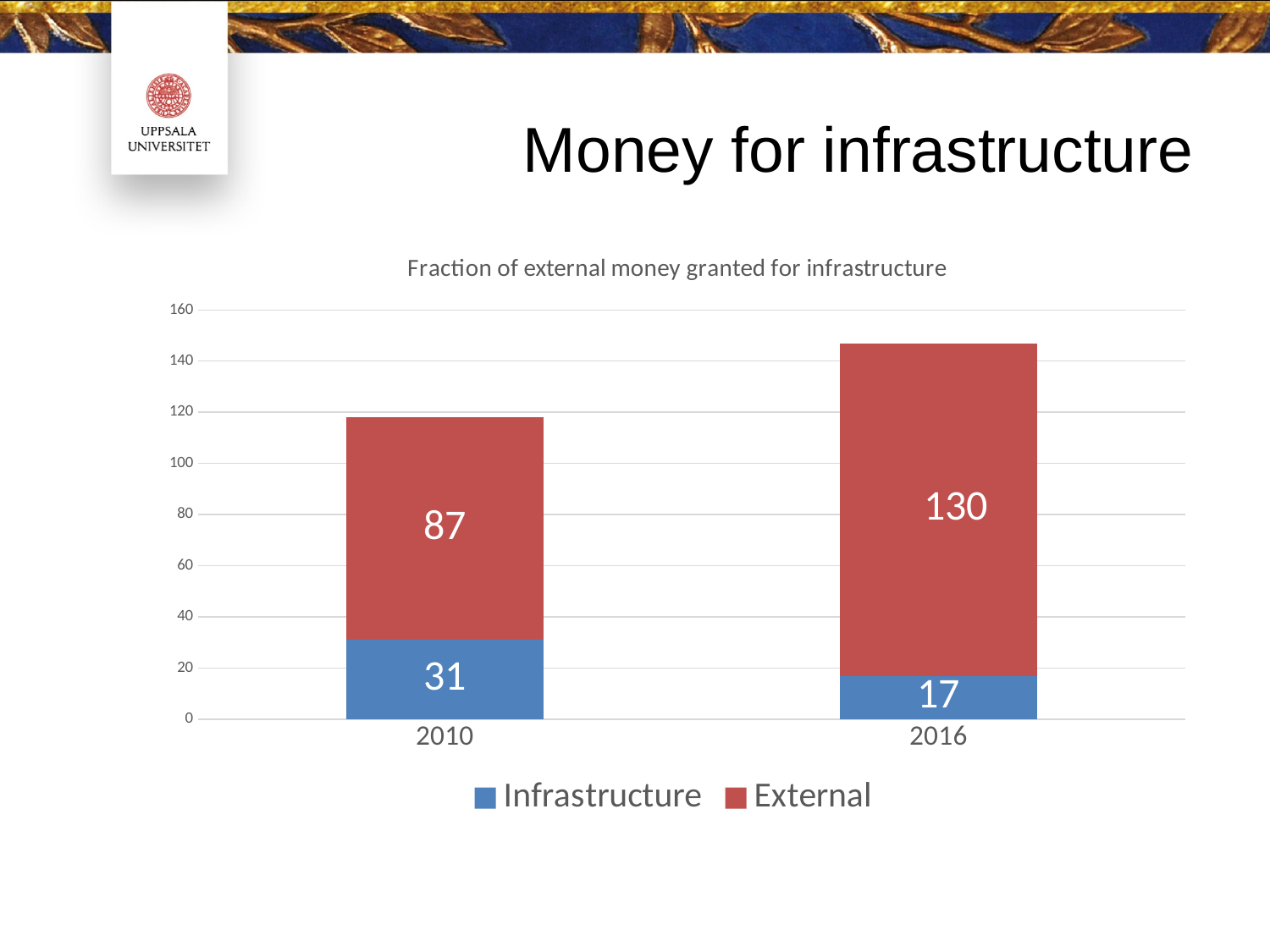
What is the title of the chart? Fraction of external money granted for infrastructure Which year has the higher External value? 2016 Which year has the lower Infrastructure value? 2016 What is the Infrastructure value for 2016? 17 What is the total of the stacked bar for 2010? 118 What is the difference between the External values for 2016 and 2010? 43 What is the total of the stacked bar for 2016? 147 What is the External value for 2016? 130 Is the Infrastructure value for 2010 larger or smaller than the Infrastructure value for 2016? larger What is the External value for 2010? 87 What is the Infrastructure value for 2010? 31 How many series does the legend list? 2